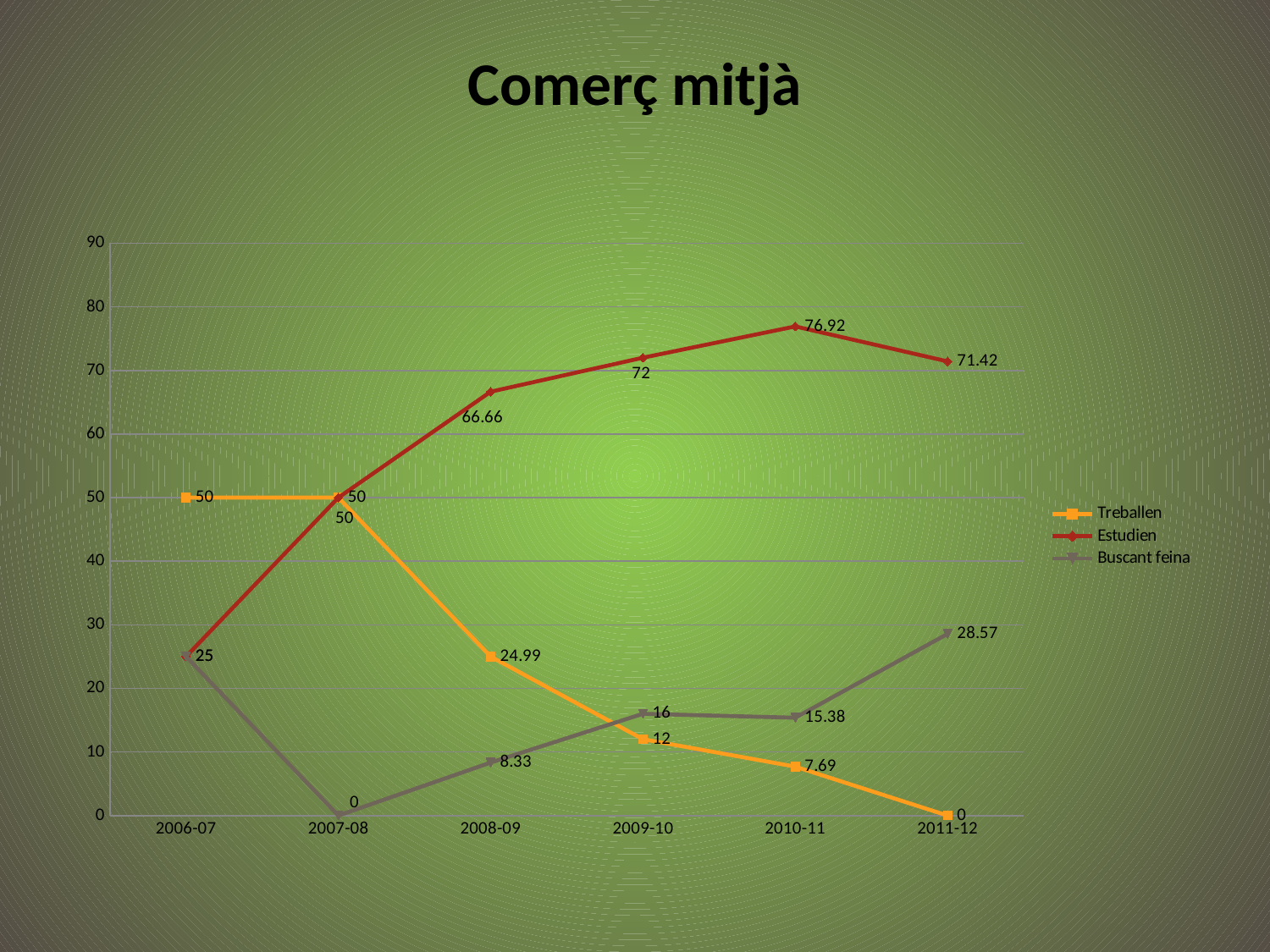
In which year does Estudien reach its highest value? 2010-11 What is the value for Buscant feina in 2011-12? 28.57 What is the difference between Estudien and Treballen in 2011-12? 71.42 What is the title of the chart? Comerç mitjà Does the Treballen series rise or fall from 2007-08 to 2011-12? fall In which year is Buscant feina at its lowest value? 2007-08 How many series does the legend list? 3 What is the value for Estudien in 2010-11? 76.92 What is the value for Treballen in 2008-09? 24.99 What type of chart is shown on the slide? line chart How many academic years are shown on the x axis? 6 Which is larger in 2009-10, Buscant feina or Treballen? Buscant feina